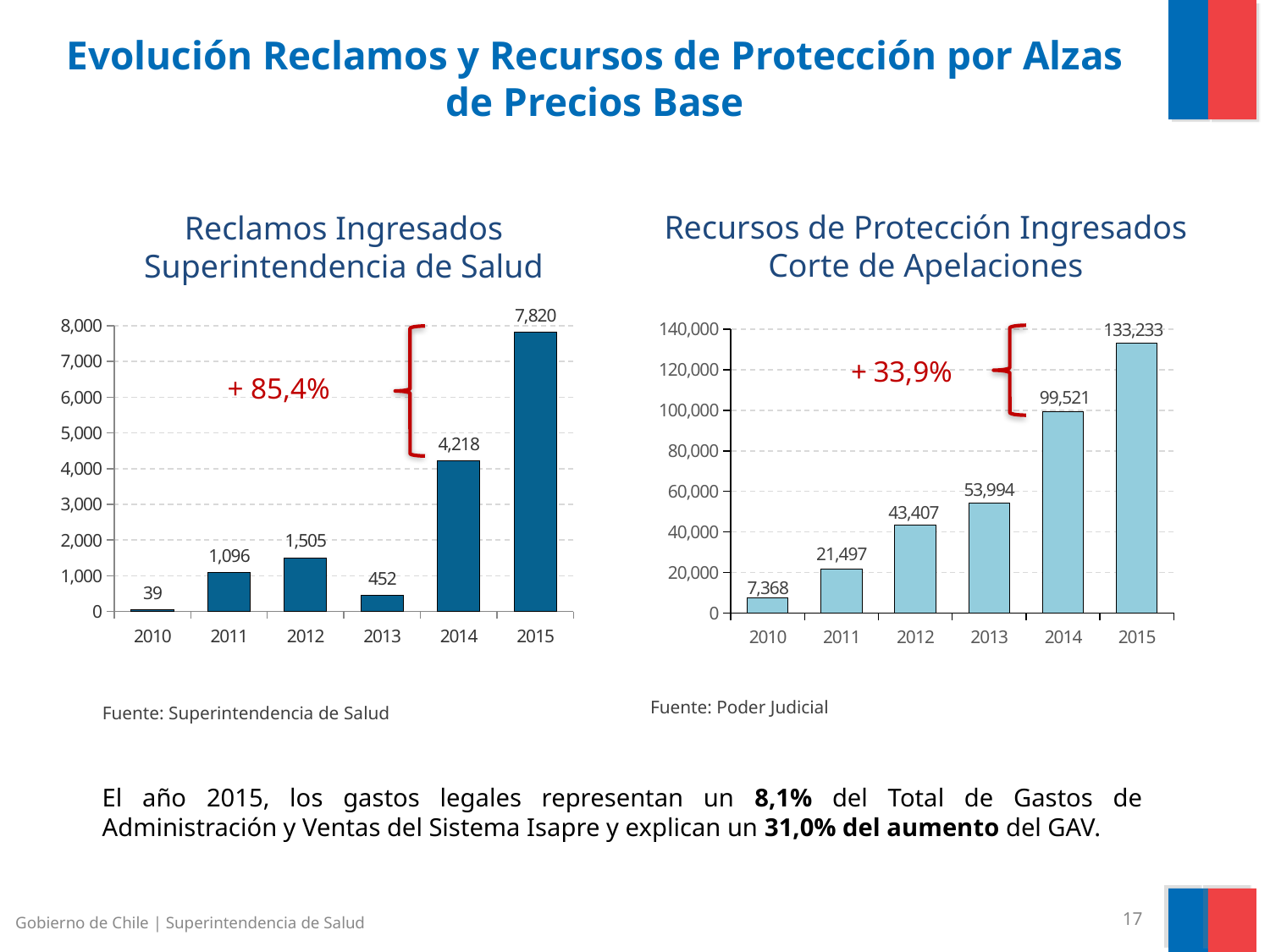
In the 'Reclamos Ingresados Superintendencia de Salud' chart, what is the value for 2014? 4,218 In the 'Recursos de Protección Ingresados Corte de Apelaciones' chart, what is the value for 2012? 43,407 In the 'Recursos de Protección Ingresados Corte de Apelaciones' chart, is the value for 2011 greater or less than 40,000? less In the 'Reclamos Ingresados Superintendencia de Salud' chart, which year has the lowest value? 2010 How many years are shown on the x axis of the 'Reclamos Ingresados Superintendencia de Salud' chart? 6 In the 'Recursos de Protección Ingresados Corte de Apelaciones' chart, what is the difference between the 2014 and 2013 values? 45,527 In the 'Reclamos Ingresados Superintendencia de Salud' chart, which is larger, the value for 2012 or the value for 2013? 2012 In the 'Recursos de Protección Ingresados Corte de Apelaciones' chart, which year has the highest value? 2015 What percentage increase is annotated between 2014 and 2015 on the 'Reclamos Ingresados Superintendencia de Salud' chart? + 85,4% In the 'Reclamos Ingresados Superintendencia de Salud' chart, what is the difference between the 2015 and 2014 values? 3,602 What kind of chart is the 'Recursos de Protección Ingresados Corte de Apelaciones' chart? bar chart In the 'Recursos de Protección Ingresados Corte de Apelaciones' chart, do the values rise or fall from 2010 to 2015? rise